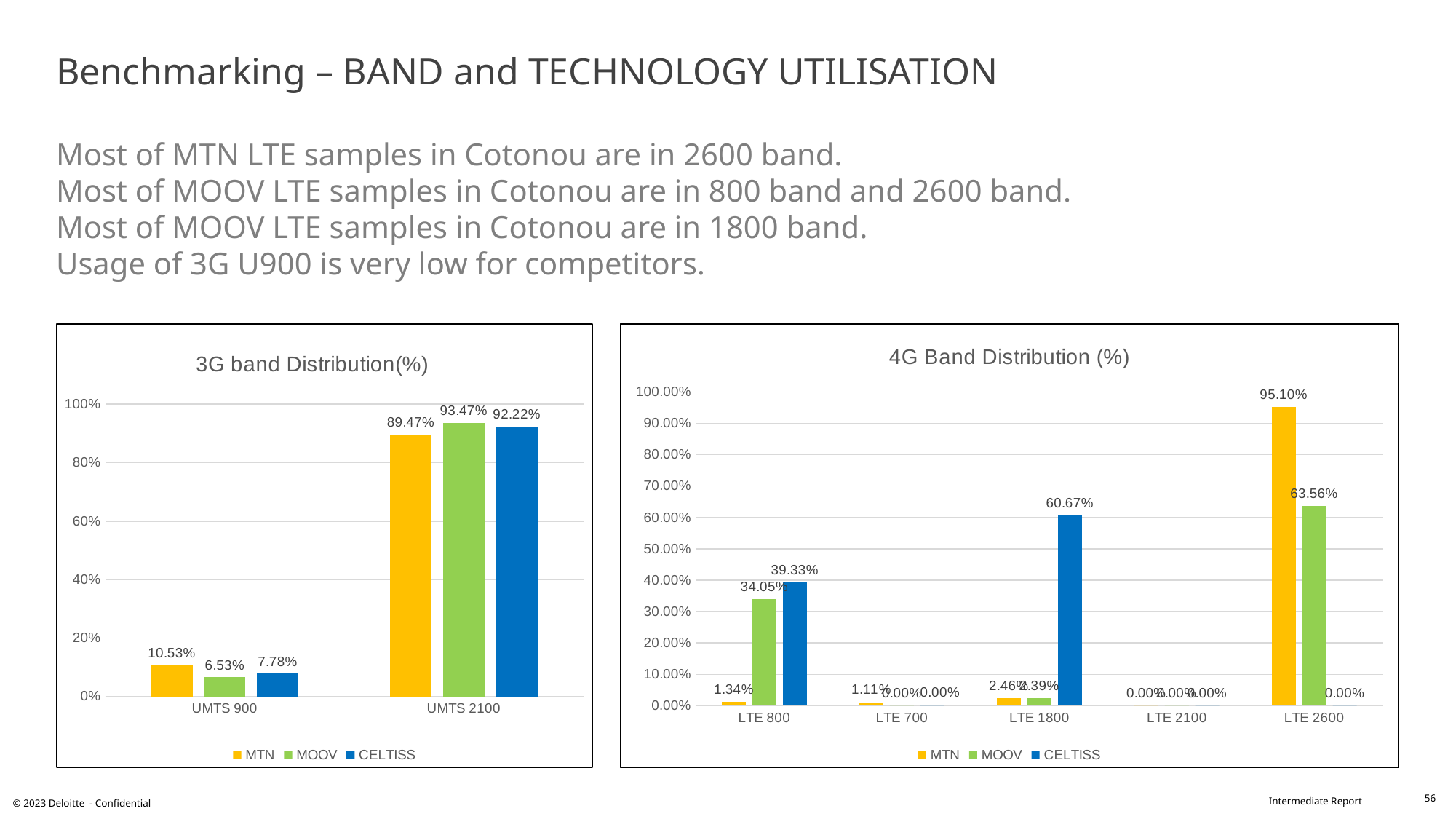
In the 4G Band Distribution (%) chart, what is the value for MTN at LTE 2600? 95.10% In the 3G band Distribution(%) chart, which series has the highest value at UMTS 2100? MOOV In the 4G Band Distribution (%) chart, what is the value for MOOV at LTE 800? 34.05% In the 4G Band Distribution (%) chart, what is the difference between the MTN and MOOV values at LTE 2600? 31.54% In the 3G band Distribution(%) chart, what is the difference between the MTN values at UMTS 2100 and UMTS 900? 78.94% In the 4G Band Distribution (%) chart, how many band categories are shown on the x axis? 5 In the 3G band Distribution(%) chart, what is the value for MOOV at UMTS 2100? 93.47% In the 3G band Distribution(%) chart, how many series does the legend list? 3 In the 4G Band Distribution (%) chart, what is the value for CELTISS at LTE 1800? 60.67% In the 3G band Distribution(%) chart, what is the value for MTN at UMTS 900? 10.53% In the 4G Band Distribution (%) chart, which is larger at LTE 800: the MOOV value or the CELTISS value? CELTISS What kind of chart is the 4G Band Distribution (%) chart? Bar chart